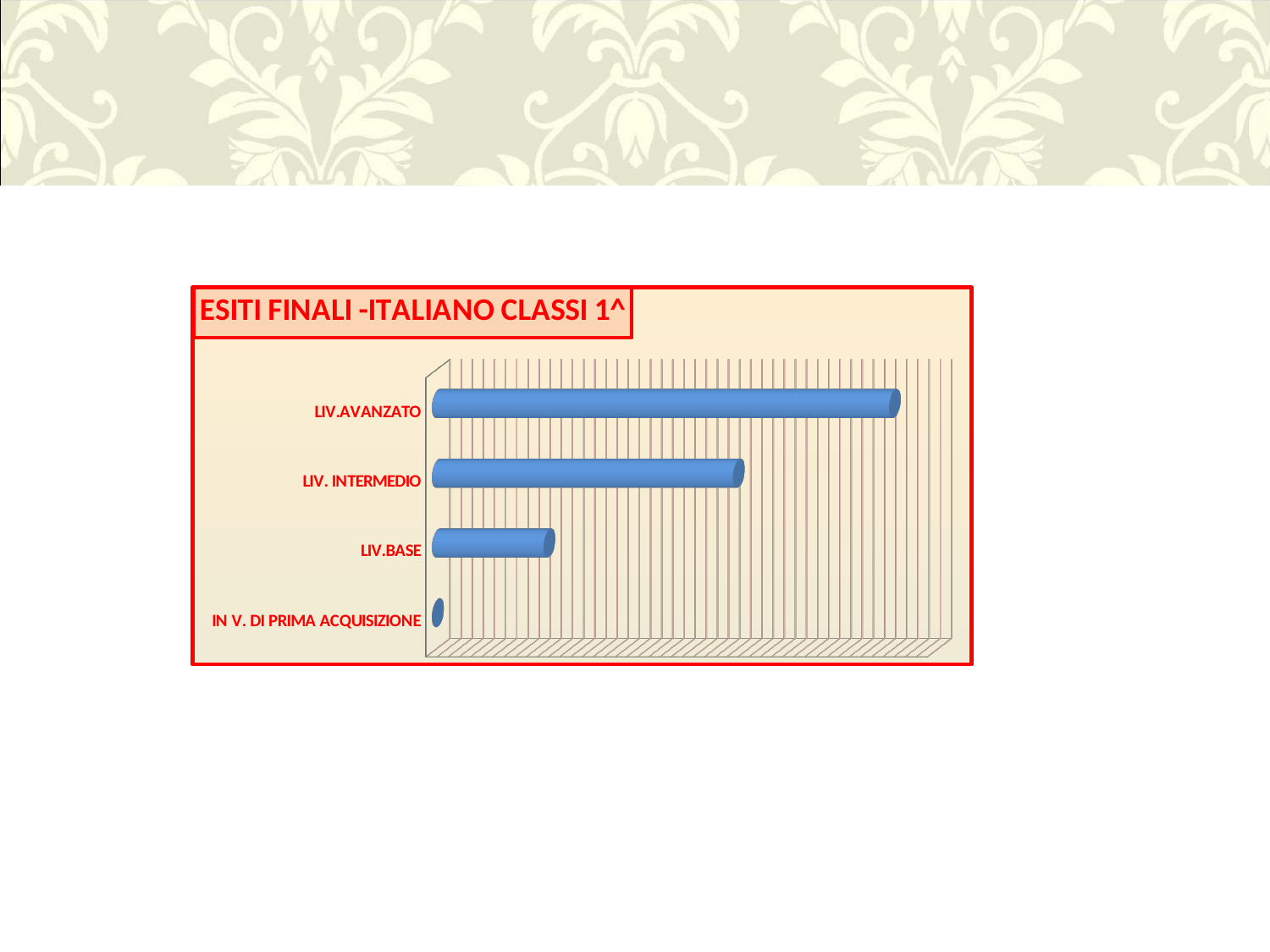
How many categories are plotted in the chart? 4 Are the bars in the chart horizontal or vertical? horizontal What is the title of the chart? ESITI FINALI -ITALIANO CLASSI 1^ Which category has the lowest value? IN V. DI PRIMA ACQUISIZIONE Which is larger, the value for LIV. INTERMEDIO or the value for LIV.BASE? LIV. INTERMEDIO Which category has the highest value? LIV.AVANZATO Which is larger, the value for LIV.AVANZATO or the value for LIV. INTERMEDIO? LIV.AVANZATO Which is larger, the value for LIV.BASE or the value for IN V. DI PRIMA ACQUISIZIONE? LIV.BASE What kind of chart is shown on the slide? bar chart What colour are the bars in the chart? blue